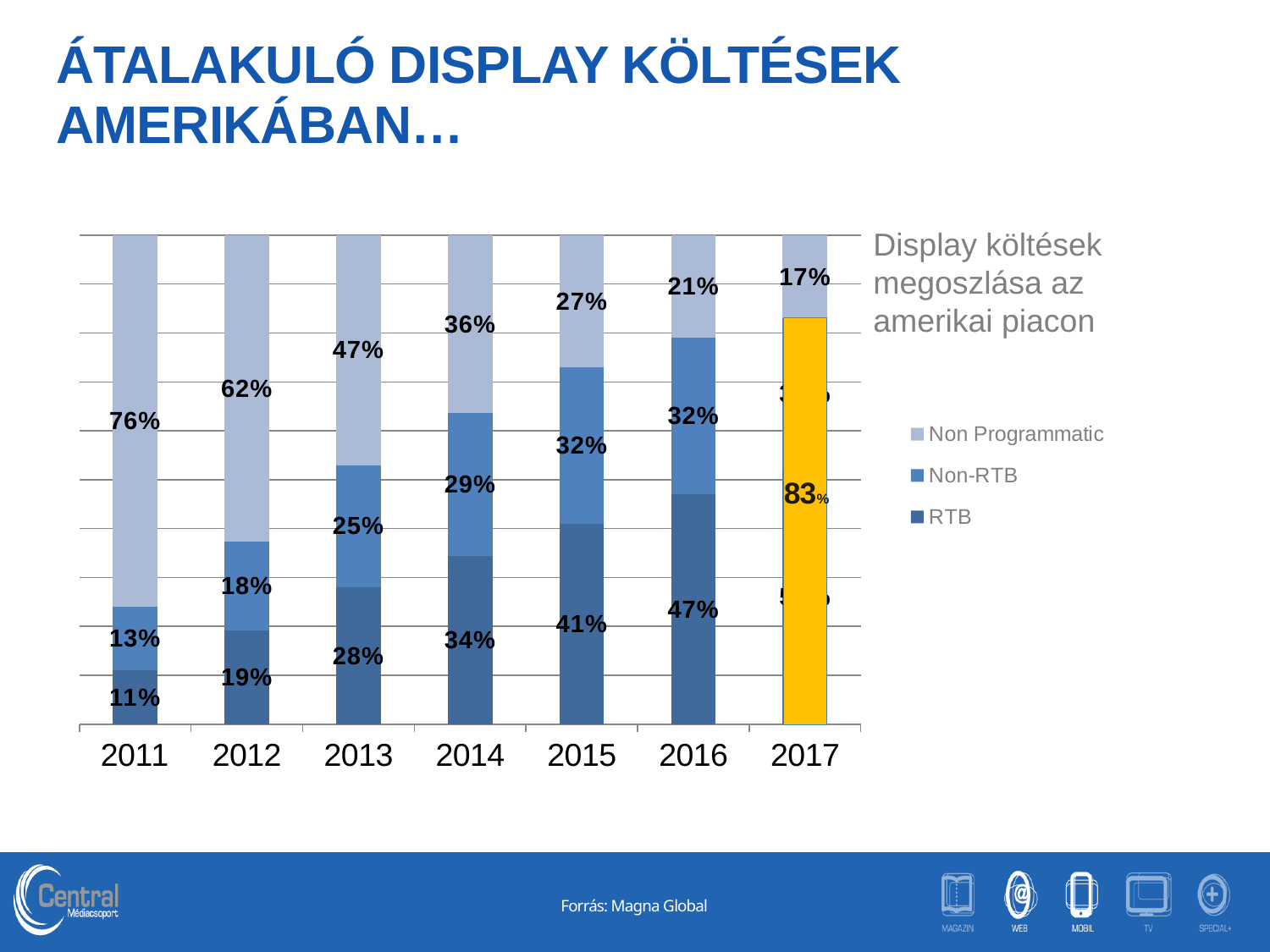
Does the RTB share rise or fall from 2011 to 2016? rise What is the Non Programmatic share in 2017? 17% What is the RTB share in 2016? 47% What is the difference between the RTB share in 2015 and in 2012? 22% Which year has the lowest RTB share? 2011 How many years are shown on the x axis? 7 Which year has the highest Non Programmatic share? 2011 How many series does the legend list? 3 What is the Non Programmatic share in 2011? 76% What kind of chart is shown on the slide? stacked bar chart Which is larger in 2013: the RTB share or the Non-RTB share? RTB What is the Non-RTB share in 2014? 29%